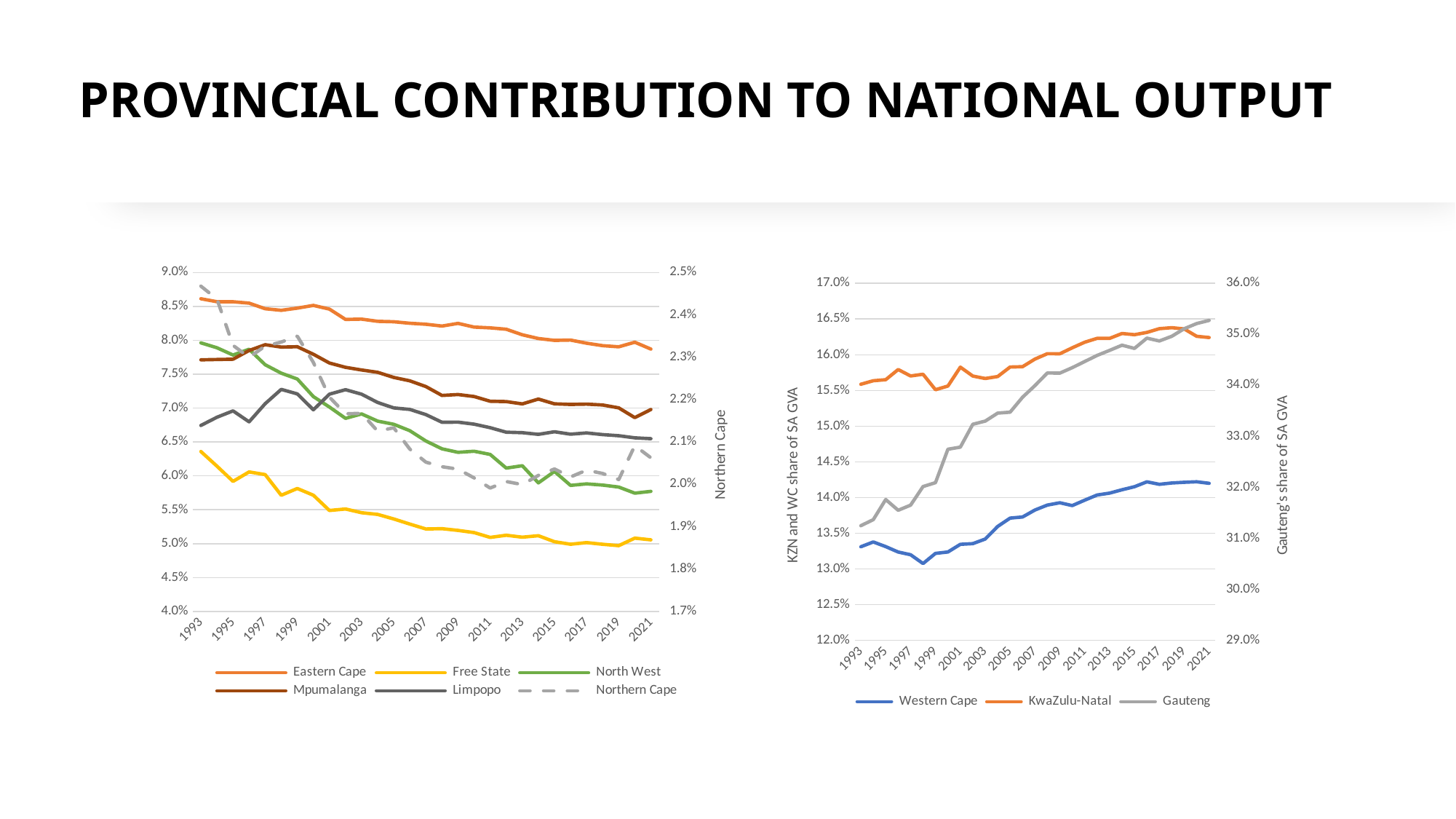
In the left chart, which is larger in 2021: Eastern Cape or Free State? Eastern Cape How many series does the legend of the left chart list? 6 How many series does the legend of the right chart list? 3 In the right chart, does the Western Cape line rise or fall from 1993 to 2021? rise In the right chart, does the Gauteng line rise or fall from 1993 to 2021? rise In the right chart, is the value for Western Cape in 1993 greater or less than 13.5%? less In the left chart, is the value for Eastern Cape in 1993 greater or less than 8.0%? greater In the left chart, does the Eastern Cape line rise or fall from 1993 to 2021? fall What kind of chart is the left chart on the slide? line chart In the left chart, is the value for Free State in 2021 greater or less than 5.5%? less In the left chart, which series is drawn with a dashed line? Northern Cape